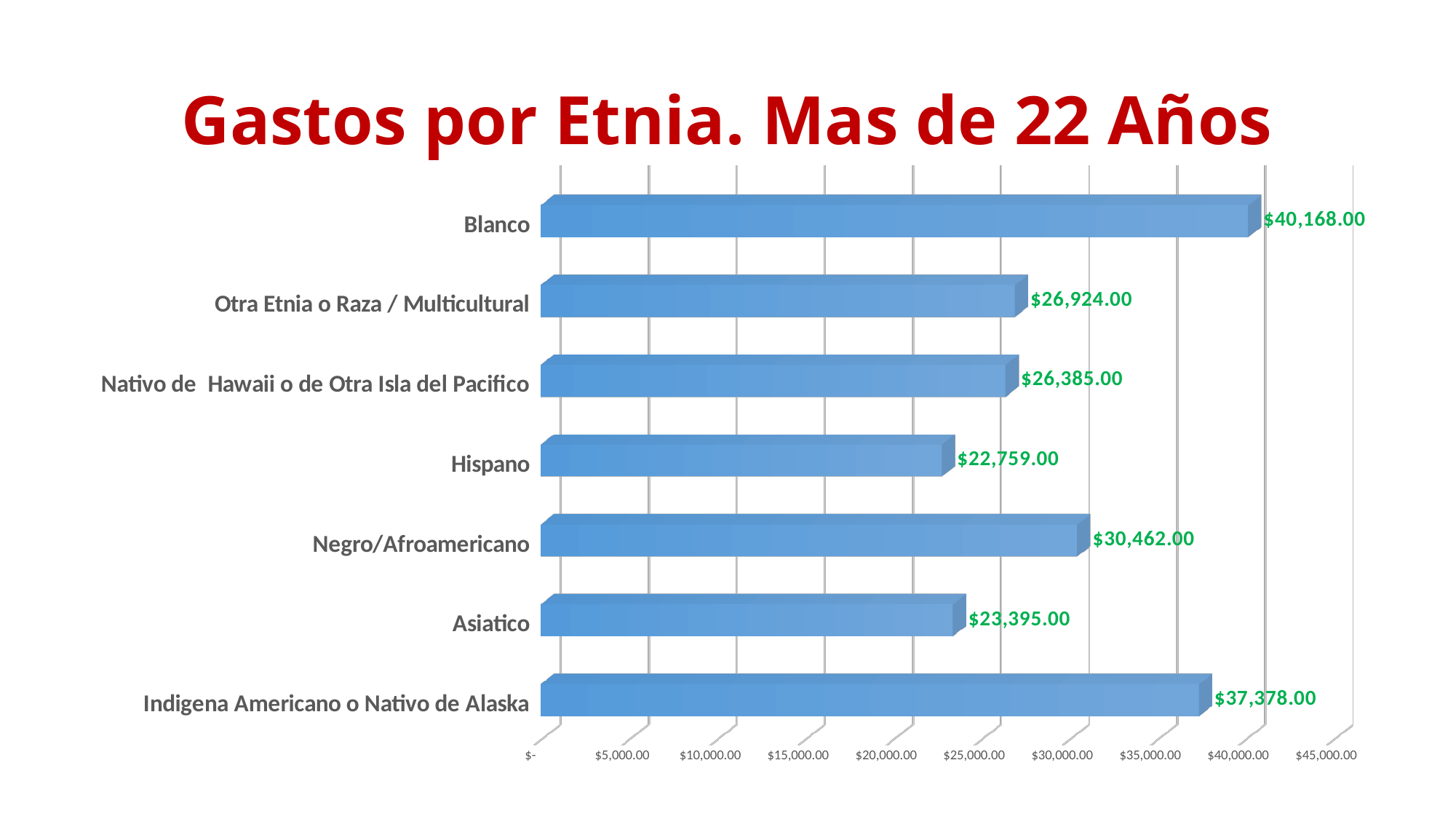
What is the value for Blanco? $40,168.00 What kind of chart is shown on the slide? bar chart What is the value for Hispano? $22,759.00 How many categories are shown in the chart? 7 Which is larger, the value for Negro/Afroamericano or the value for Asiatico? Negro/Afroamericano Is the value for Hispano greater or less than $25,000.00? less What is the difference between the values for Negro/Afroamericano and Asiatico? $7,067.00 What is the difference between the values for Blanco and Hispano? $17,409.00 What is the value for Indigena Americano o Nativo de Alaska? $37,378.00 Which category has the lowest value? Hispano What is the value for Negro/Afroamericano? $30,462.00 Which category has the highest value? Blanco